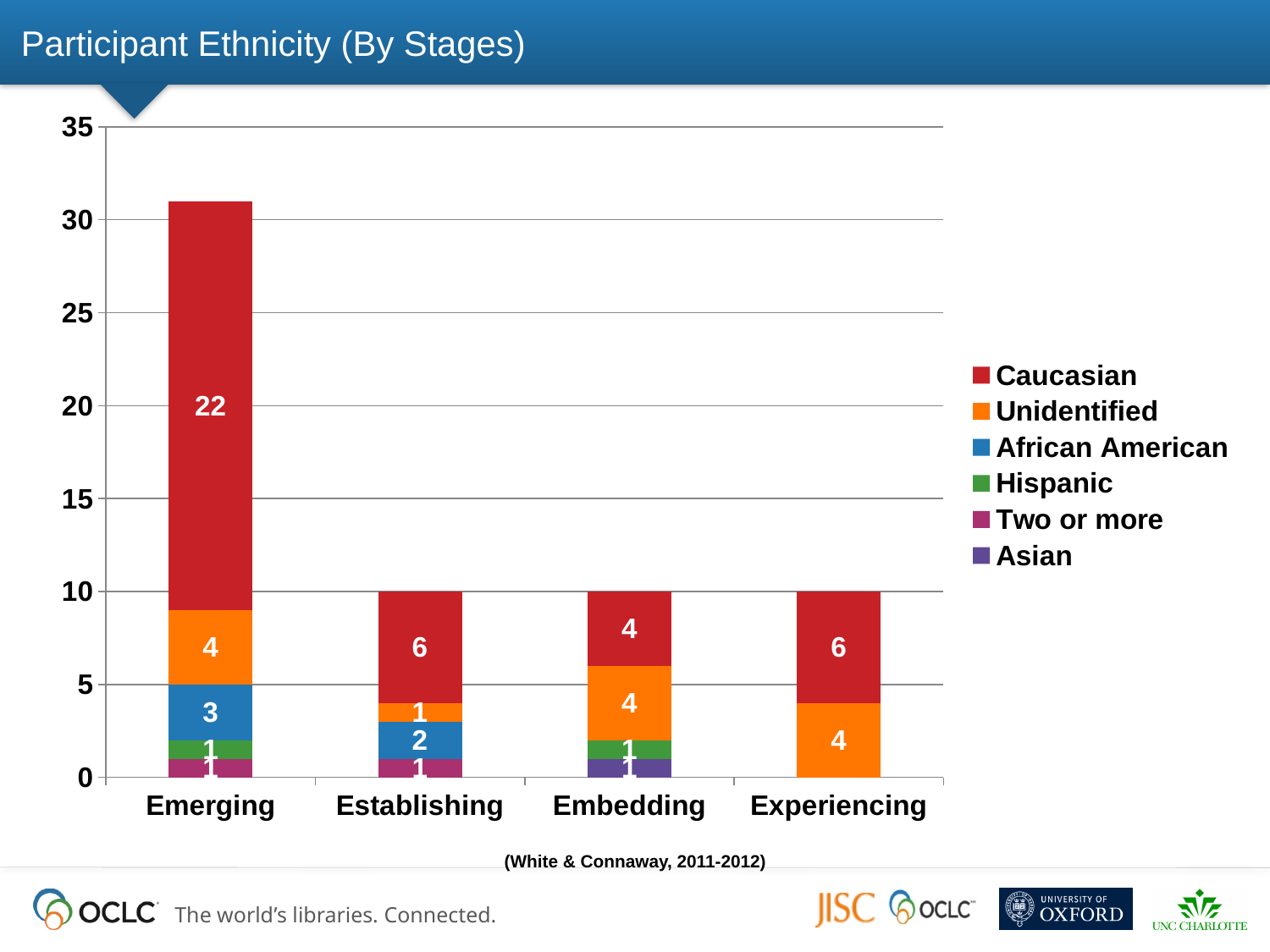
What is the total of the stacked bar for the Experiencing stage? 10 Which stage has the tallest stacked bar overall? Emerging What kind of chart is shown on the slide? Stacked bar chart Which stage has the larger Caucasian value, Establishing or Embedding? Establishing What is the total of the stacked bar for the Emerging stage? 31 How many stages are shown on the x axis? 4 Is the total for the Emerging stage greater or less than 30? greater What is the Caucasian value for the Emerging stage? 22 What is the difference between the Caucasian values for Emerging and Establishing? 16 How many series does the legend list? 6 What is the Unidentified value for the Experiencing stage? 4 What is the African American value for the Establishing stage? 2